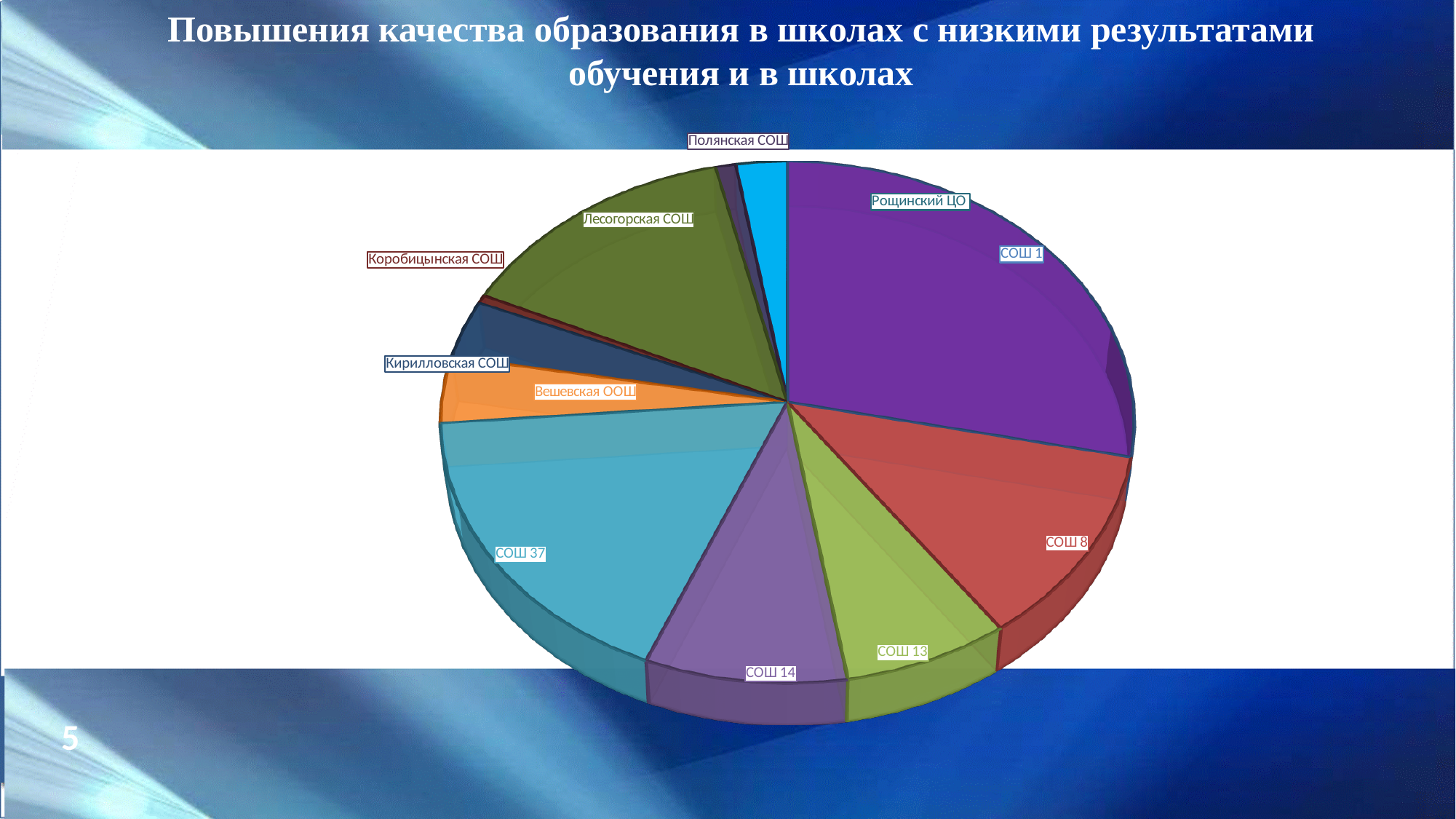
Which slice is larger, Лесогорская СОШ or Полянская СОШ? Лесогорская СОШ Which slice is larger, СОШ 14 or Кирилловская СОШ? СОШ 14 What is the title of the slide containing the pie chart? Повышения качества образования в школах с низкими результатами обучения и в школах Which slice is larger, СОШ 37 or СОШ 13? СОШ 37 What colour is the slice labelled СОШ 8? Red How many labelled categories does the pie chart show? 11 What kind of chart is shown on the slide? Pie chart